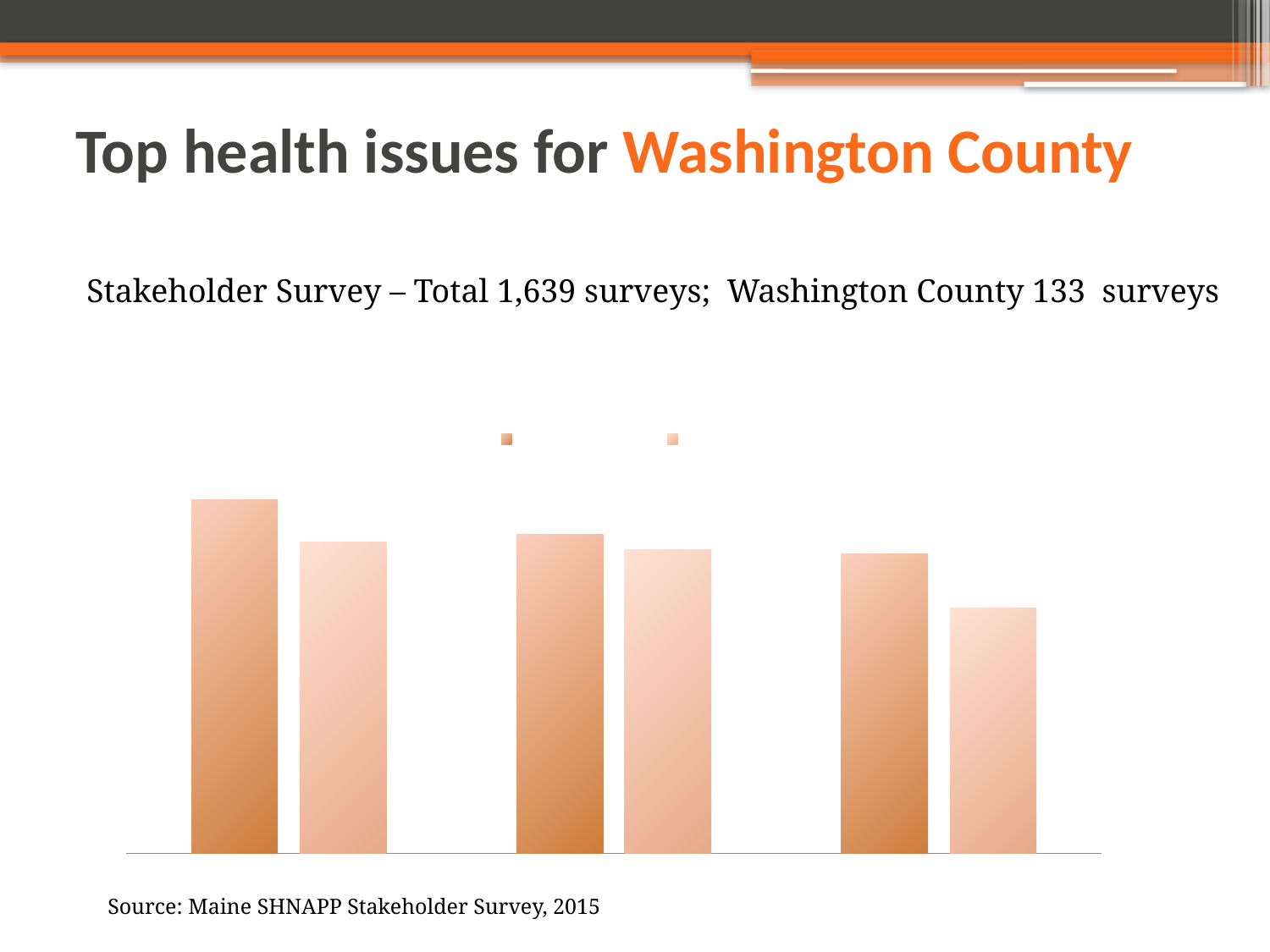
In the leftmost group, which bar is taller: the darker orange bar or the lighter orange bar? the darker orange bar Which group of bars contains the tallest bar in the chart: the leftmost, middle, or rightmost? leftmost Which group of bars contains the shortest bar in the chart: the leftmost, middle, or rightmost? rightmost How many bars are plotted in the chart in total? 6 How many groups of bars are plotted in the chart? 3 How many series does the chart's legend list? 2 What source is cited below the chart? Maine SHNAPP Stakeholder Survey, 2015 Do the darker orange bars rise or fall from left to right across the chart? fall What kind of chart is shown on the slide? bar chart In the rightmost group, which bar is taller: the darker orange bar or the lighter orange bar? the darker orange bar Do the lighter orange bars rise or fall from left to right across the chart? fall How many bars are in each group of the chart? 2